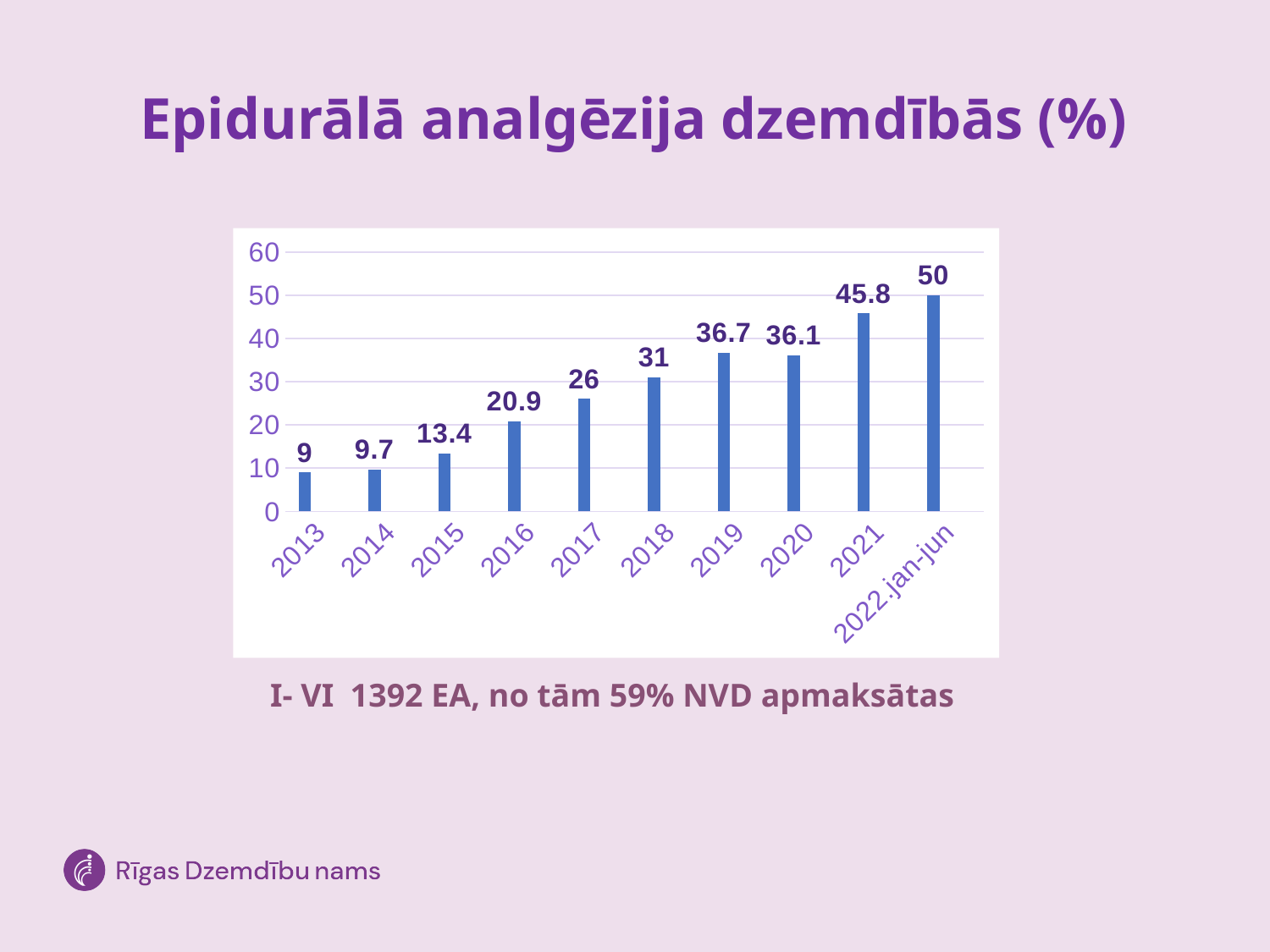
What kind of chart is this? bar chart What is the value for 2022.jan-jun? 50 Which category has the lowest value? 2013 Do the values generally rise or fall from 2013 to 2022.jan-jun? rise What is the value for 2019? 36.7 What is the value for 2016? 20.9 Which category has the highest value? 2022.jan-jun What is the difference between the values for 2021 and 2020? 9.7 What is the title of the slide? Epidurālā analgēzija dzemdībās (%) How many categories are shown on the x axis? 10 Is the value for 2015 greater or less than 20? less Which is larger, the value for 2017 or the value for 2018? 2018